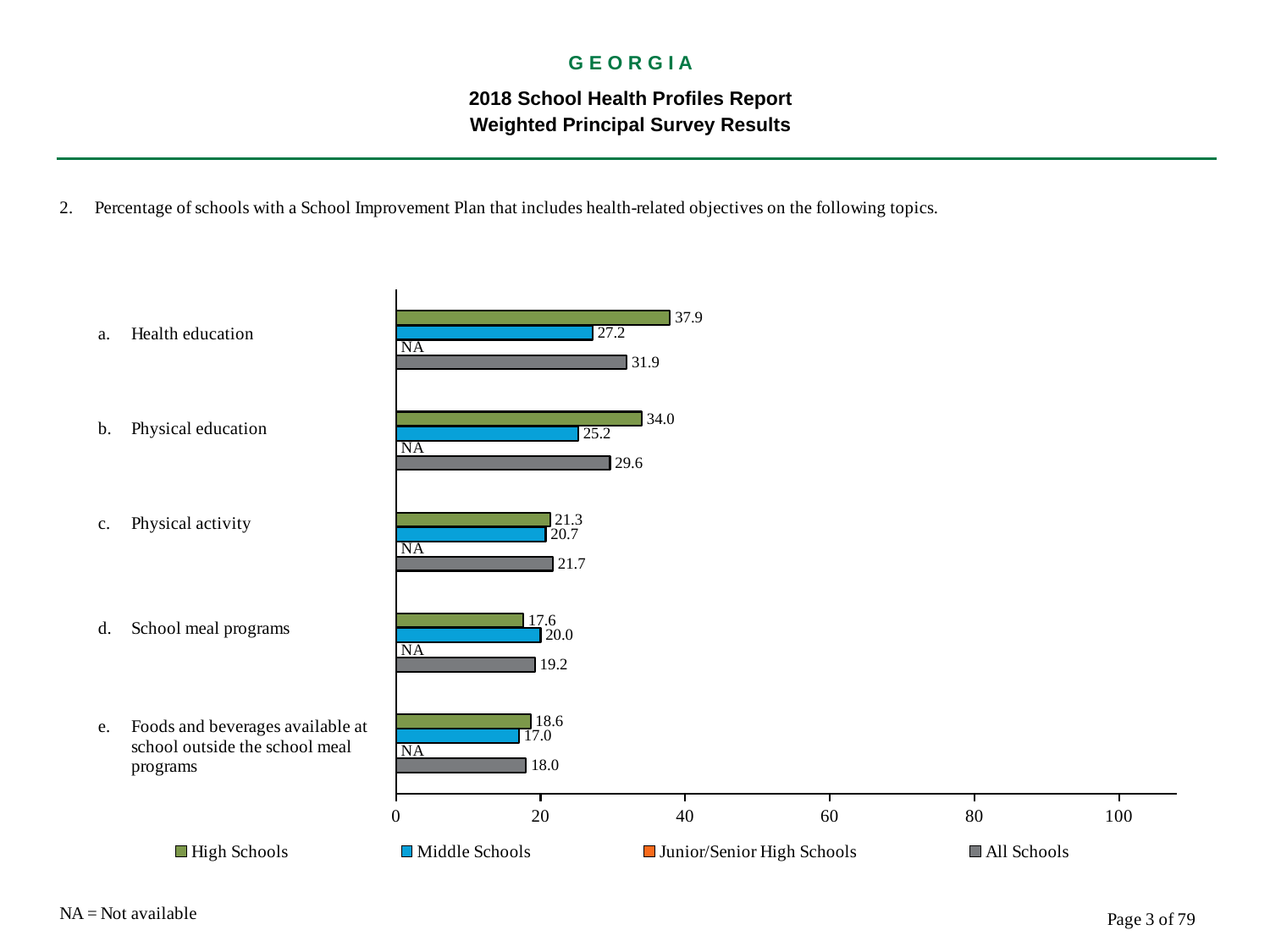
What is the value for Middle Schools for Physical education? 25.2 Which is larger for School meal programs: the High Schools value or the Middle Schools value? Middle Schools Which topic has the lowest value for Middle Schools? Foods and beverages available at school outside the school meal programs What is the value for Junior/Senior High Schools for Physical activity? NA What is the value for All Schools for School meal programs? 19.2 Is the All Schools value for Physical education greater or less than 20? greater What kind of chart is shown on the slide? bar chart What is the difference between the High Schools and Middle Schools values for Health education? 10.7 What is the value for High Schools for Health education? 37.9 How many topics (categories) are shown on the chart? 5 How many series does the legend list? 4 Which topic has the highest value for High Schools? Health education